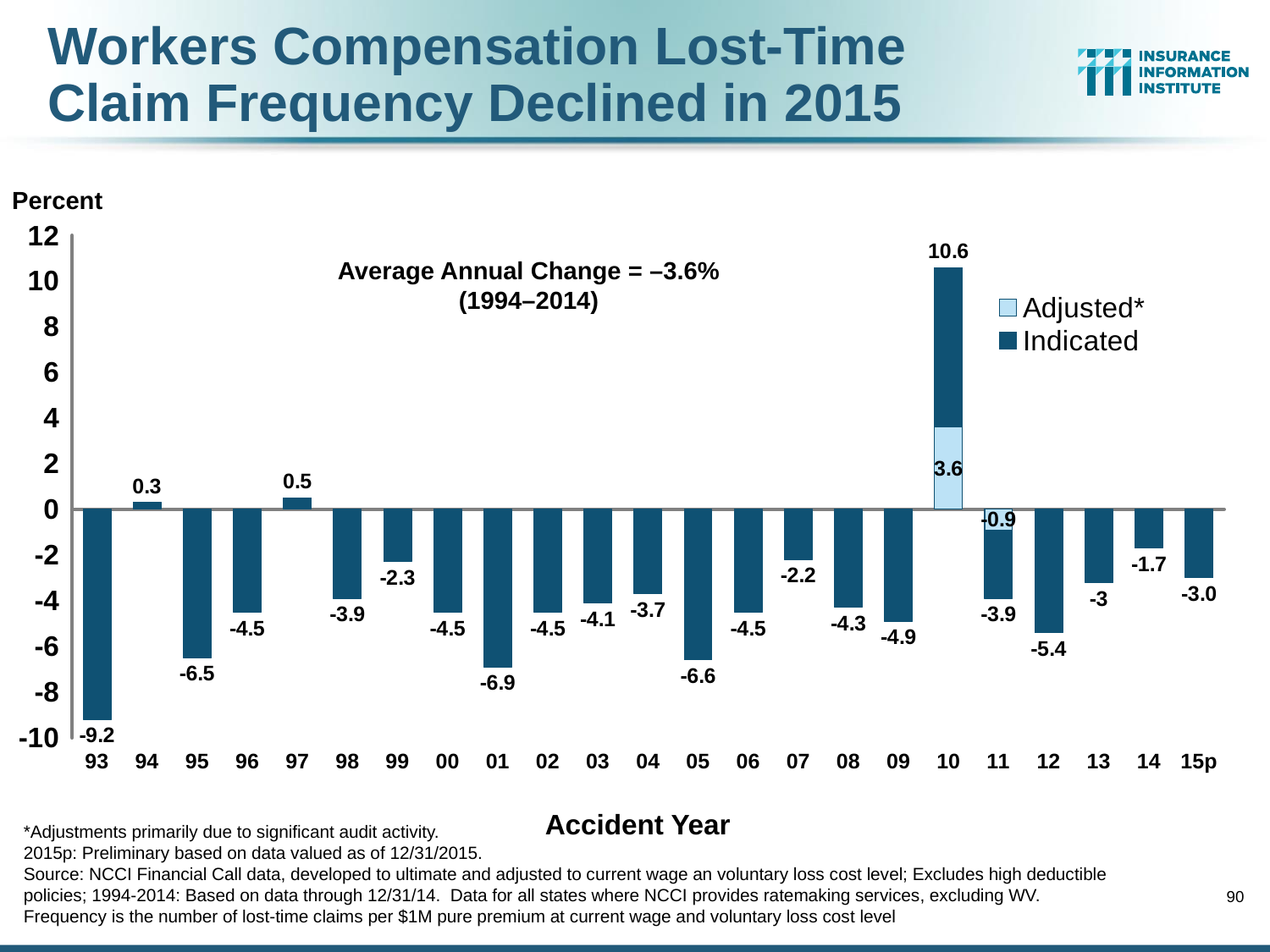
Which is larger, the value for accident year 94 or for accident year 97? 97 Which accident year has the highest value? 10 What average annual change is stated on the chart for 1994–2014? –3.6% What is the value for accident year 93? -9.2 Which accident year has the lowest value? 93 What is the Adjusted value for accident year 10? 3.6 What is the Indicated value for accident year 10? 10.6 What is the difference between the values for accident years 01 and 05? 0.3 How many series does the legend list? 2 What is the value for accident year 15p? -3.0 What kind of chart is shown on the slide? Bar chart How many accident years are shown on the x axis? 23